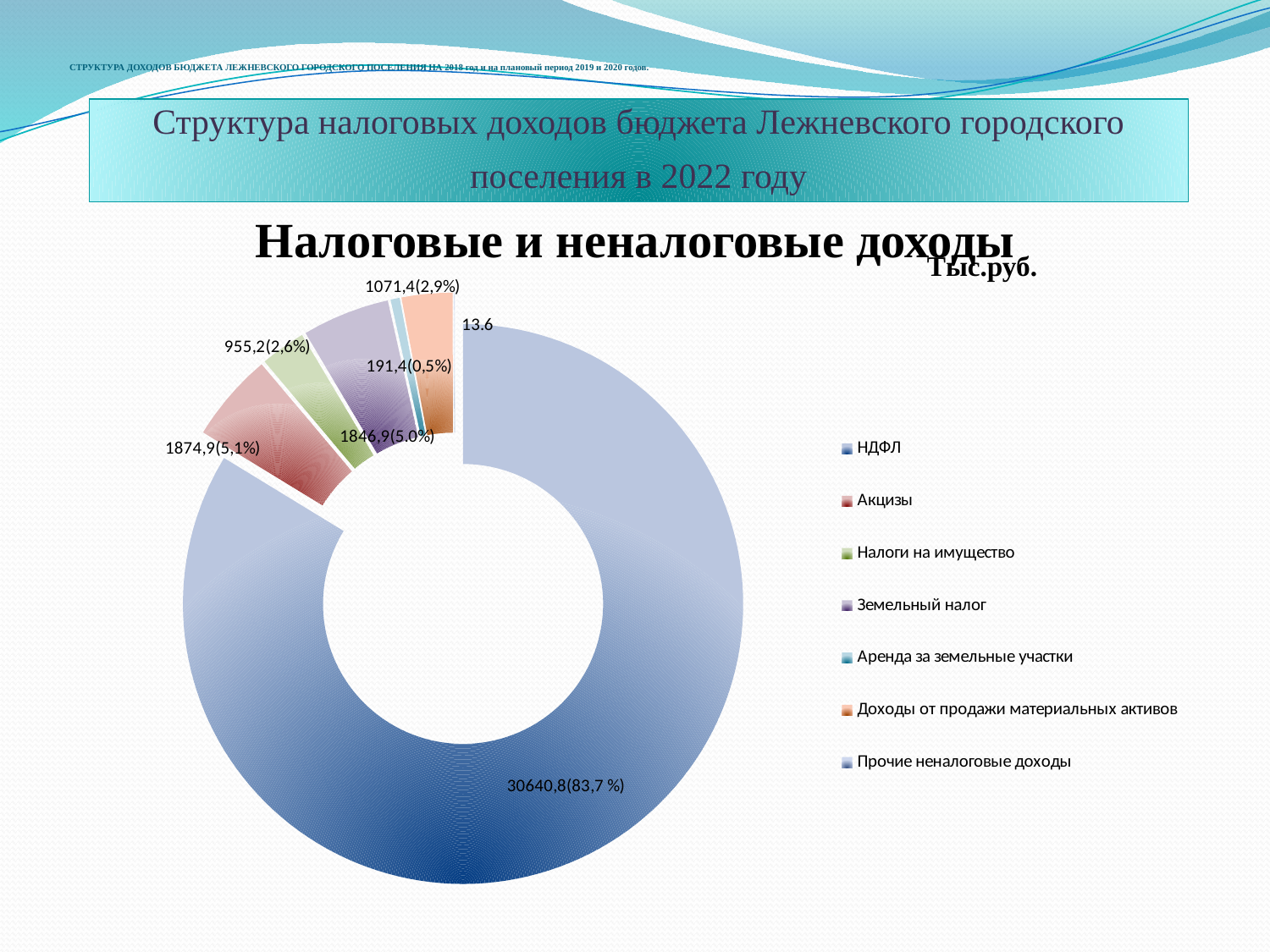
What kind of chart is shown on the slide? Pie (doughnut) chart What is the value shown for Акцизы? 1874,9 What is the value shown for НДФЛ? 30640,8 What is the value shown for Прочие неналоговые доходы? 13.6 Which category has the largest slice of the chart? НДФЛ What share of the total does НДФЛ account for? 83,7 % Which category has the smallest slice of the chart? Прочие неналоговые доходы What share of the total do Акцизы account for? 5,1% What is the value shown for Аренда за земельные участки? 191,4 What is the title of the chart? Налоговые и неналоговые доходы What unit of measurement is indicated for the chart values? Тыс.руб. How many categories does the chart's legend list? 7